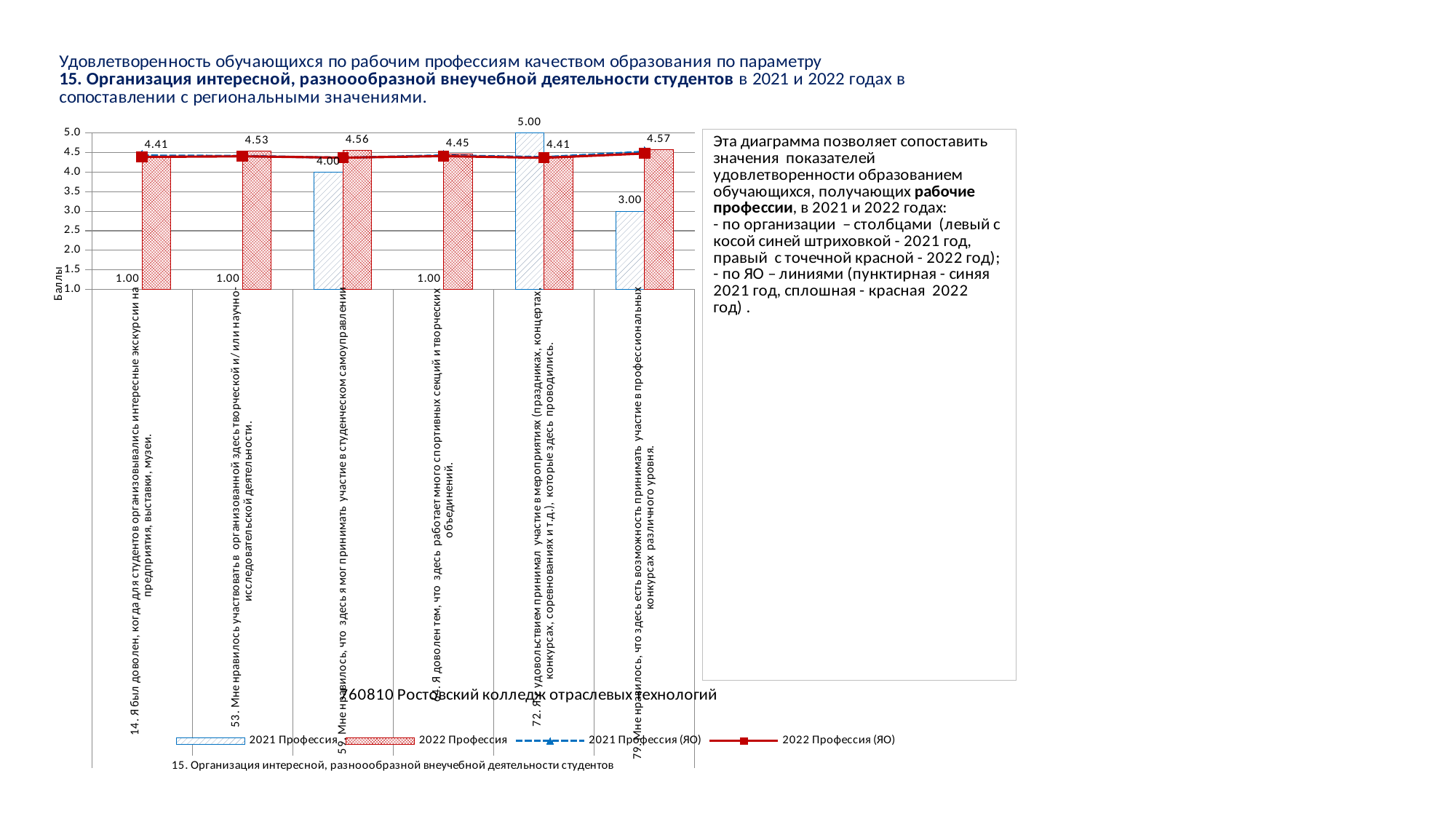
What is the value of the 2021 Профессия bar for category 79 (возможность принимать участие в профессиональных конкурсах)? 3.00 What is the title of the vertical axis of the chart? Баллы How many categories are shown on the x axis of the chart? 6 What is the value of the 2022 Профессия bar for category 79 (возможность принимать участие в профессиональных конкурсах)? 4.57 Is the 2022 Профессия (ЯО) line value for category 14 greater or less than 4.0? greater Which 2021 Профессия bar is taller: the one for студенческое самоуправление or the one for category 79 (профессиональные конкурсы)? студенческое самоуправление Which category has the highest 2021 Профессия bar? 72. Я с удовольствием принимал участие в мероприятиях What is the value of the 2021 Профессия bar for category 72 (Я с удовольствием принимал участие в мероприятиях)? 5.00 What is the difference between the 2021 Профессия values for category 72 and category 79? 2.00 What is the value of the 2022 Профессия bar for category 53 (творческой и/или научно-исследовательской деятельности)? 4.53 What is the value of the 2021 Профессия bar for category 14 (интересные экскурсии на предприятия, выставки, музеи)? 1.00 How many series does the chart legend list? 4